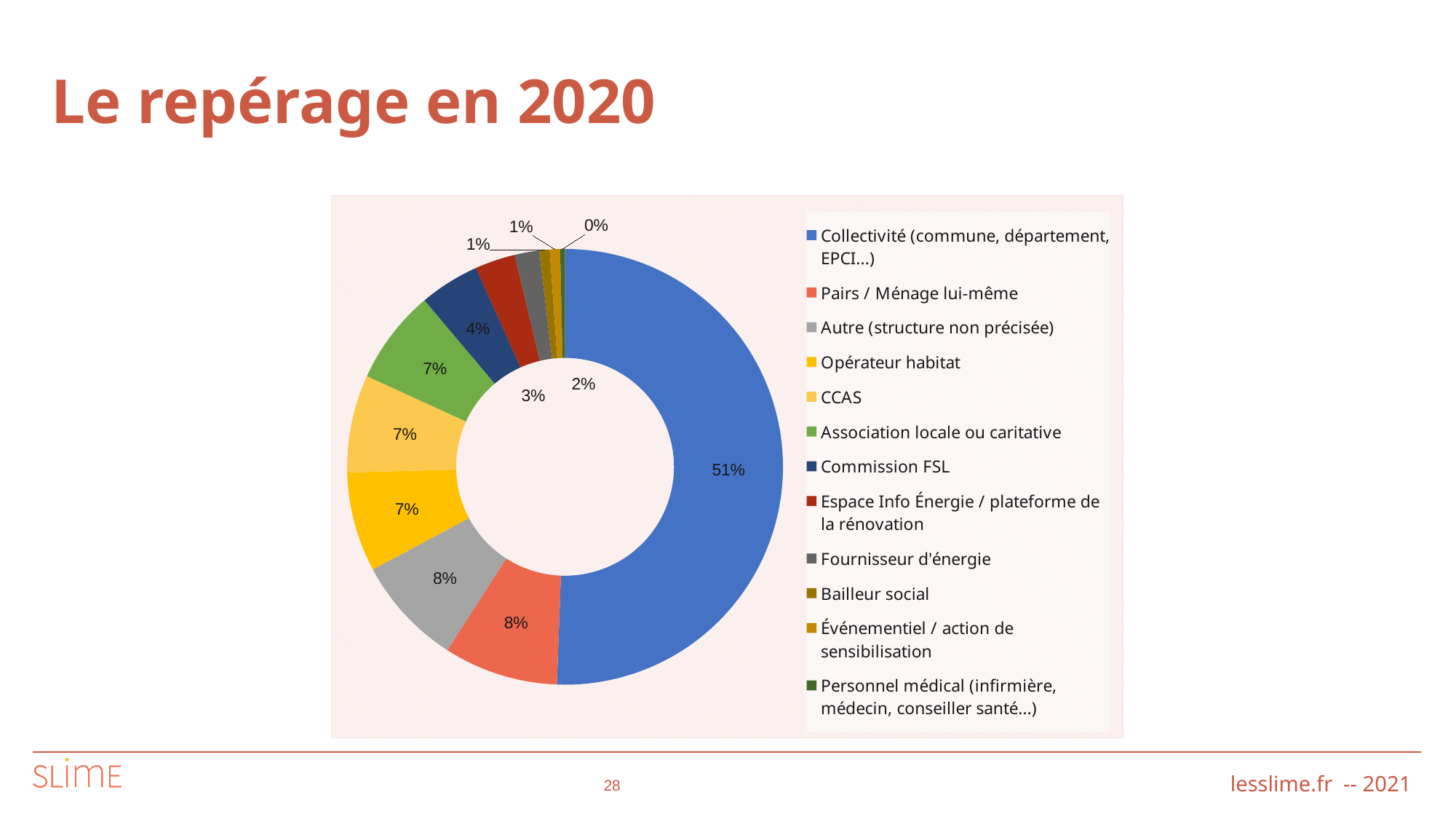
Which is larger, the share for 'Association locale ou caritative' or the share for 'Commission FSL'? Association locale ou caritative What is the value shown for 'Fournisseur d'énergie'? 2% What is the title of the slide containing the chart? Le repérage en 2020 What kind of chart is shown on the slide? pie chart (doughnut) Which category has the largest share of the pie? Collectivité (commune, département, EPCI...) What is the value shown for 'Espace Info Énergie / plateforme de la rénovation'? 3% What is the value shown for 'Pairs / Ménage lui-même'? 8% What is the value shown for 'Commission FSL'? 4% What is the difference between the share for 'Collectivité (commune, département, EPCI...)' and the share for 'Pairs / Ménage lui-même'? 43% How many categories does the legend list? 12 Which category has the smallest share of the pie? Personnel médical (infirmière, médecin, conseiller santé...) What share of the pie does 'Collectivité (commune, département, EPCI...)' represent? 51%